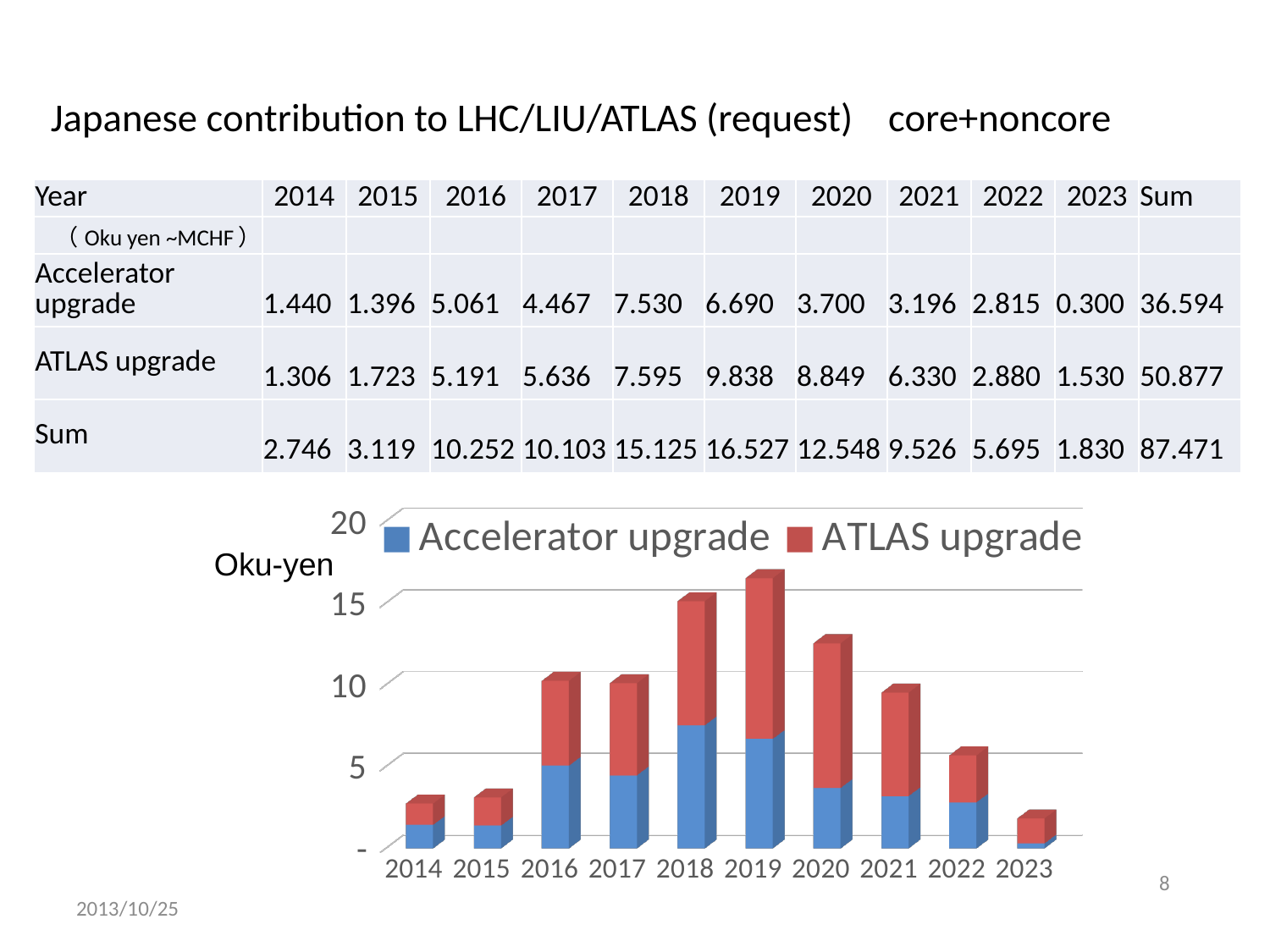
Which year has the tallest stacked bar in the chart? 2019 What kind of chart is shown on the slide? Stacked bar chart Is the total stacked bar for 2022 greater or less than 10? less How many series does the chart legend list? 2 What unit label is written next to the chart's vertical axis? Oku-yen Which is larger in 2019, the Accelerator upgrade segment or the ATLAS upgrade segment? ATLAS upgrade Which year has the shortest stacked bar in the chart? 2023 What is the total of the stacked bar for 2019, as printed in the table on the slide? 16.527 Do the total stacked bars rise or fall from 2019 to 2023? fall How many years are shown along the x axis of the chart? 10